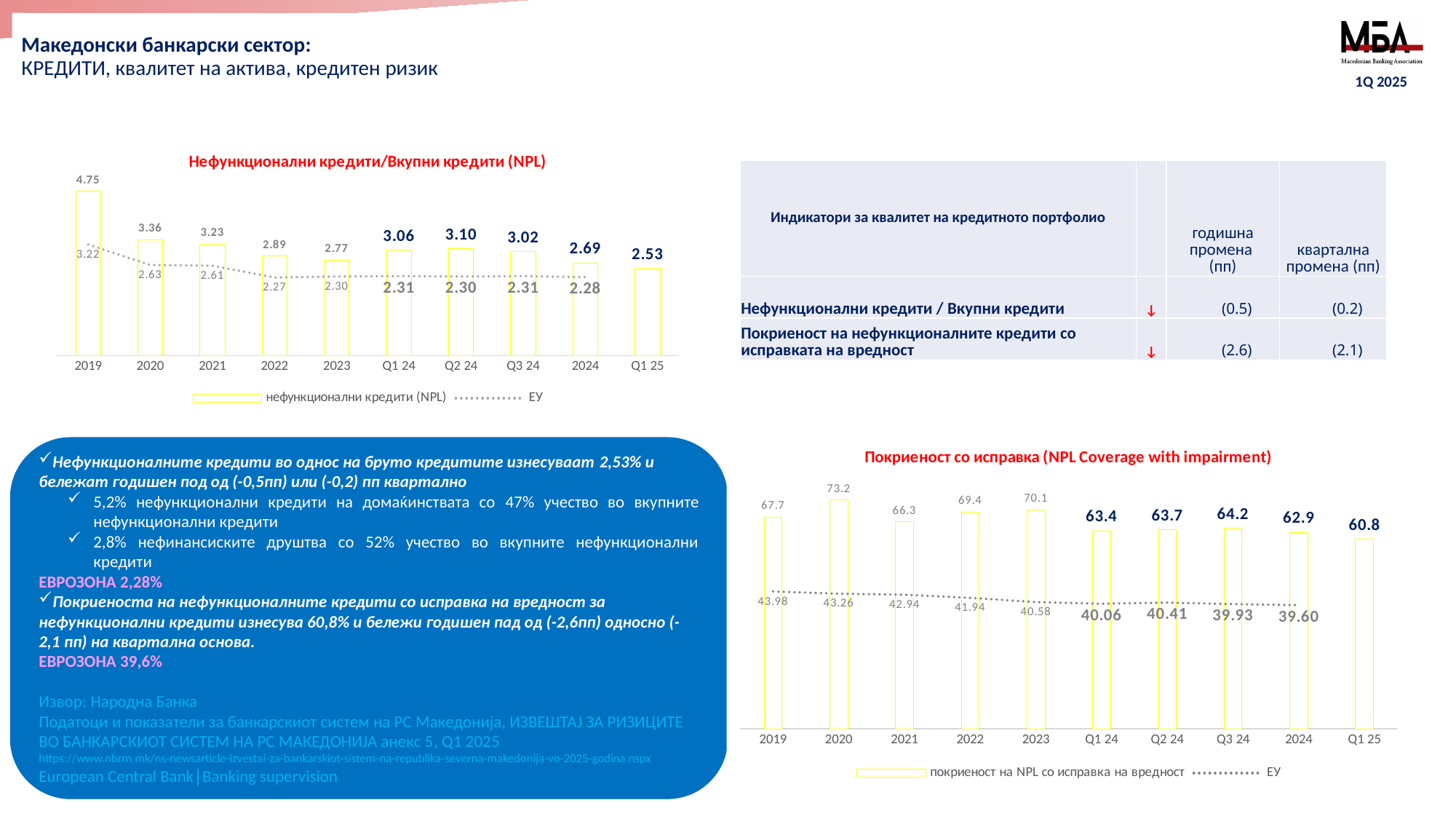
In the chart titled 'Покриеност со исправка (NPL Coverage with impairment)', what is the ЕУ value for Q1 24? 40.06 In the chart titled 'Нефункционални кредити/Вкупни кредити (NPL)', how many categories are shown on the x axis? 10 In the chart titled 'Покриеност со исправка (NPL Coverage with impairment)', which is larger, the coverage value for Q3 24 or for 2024? Q3 24 In the chart titled 'Покриеност со исправка (NPL Coverage with impairment)', what is the difference between the coverage values for 2024 and Q1 25? 2.1 In the chart titled 'Нефункционални кредити/Вкупни кредити (NPL)', which category has the highest NPL bar? 2019 In the chart titled 'Покриеност со исправка (NPL Coverage with impairment)', which category has the lowest coverage bar? Q1 25 In the chart titled 'Нефункционални кредити/Вкупни кредити (NPL)', what is the NPL value for Q1 25? 2.53 In the chart titled 'Нефункционални кредити/Вкупни кредити (NPL)', what is the ЕУ value for 2024? 2.28 What type of chart is the chart titled 'Покриеност со исправка (NPL Coverage with impairment)'? Bar chart with a line In the chart titled 'Нефункционални кредити/Вкупни кредити (NPL)', how many series does the legend list? 2 In the chart titled 'Нефункционални кредити/Вкупни кредити (NPL)', what is the difference between the NPL values for 2019 and 2020? 1.39 In the chart titled 'Покриеност со исправка (NPL Coverage with impairment)', what is the coverage value for 2020? 73.2